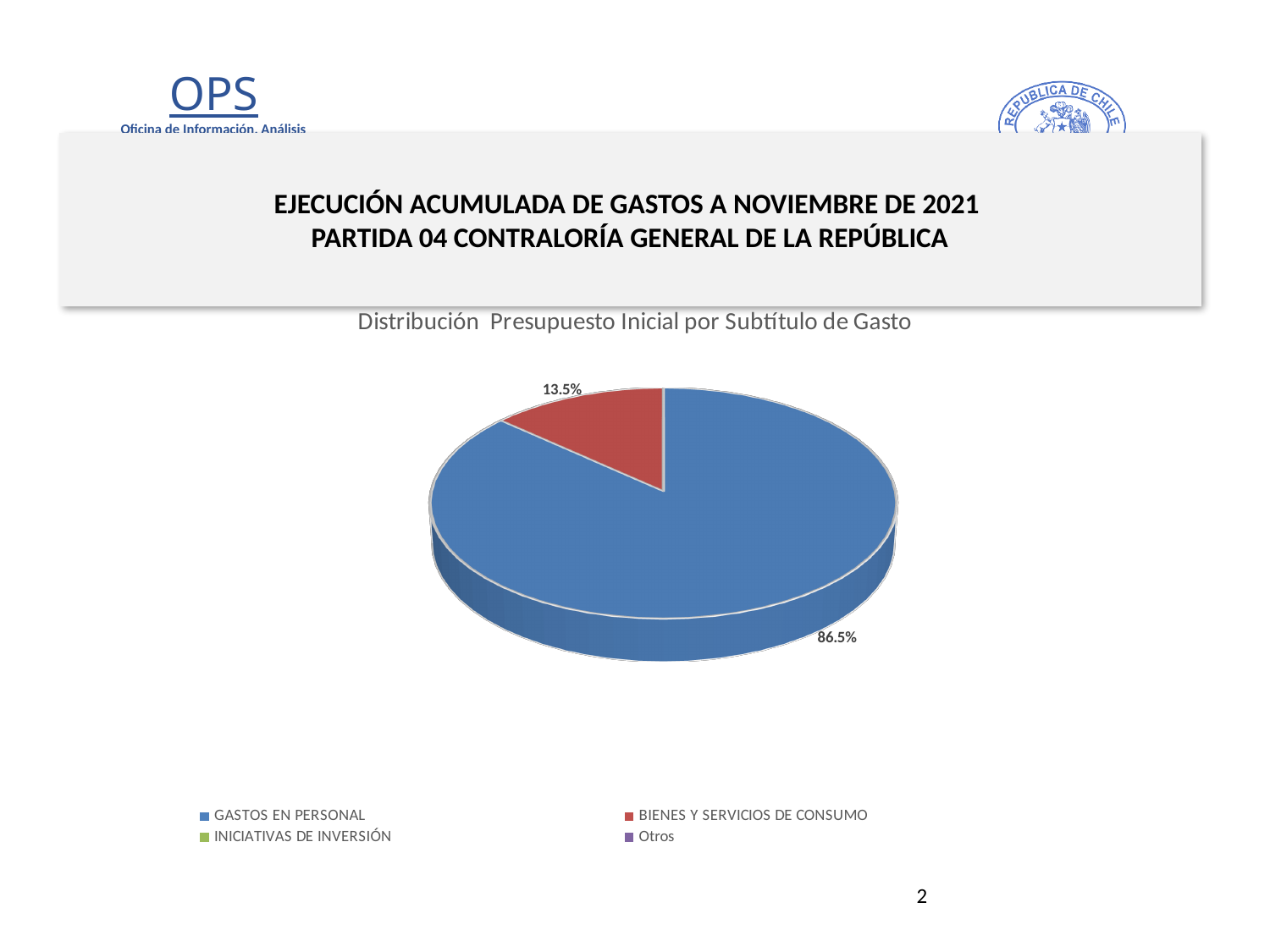
What is the title of the chart? Distribución Presupuesto Inicial por Subtítulo de Gasto What share of the pie does BIENES Y SERVICIOS DE CONSUMO represent? 13.5% What share of the pie does GASTOS EN PERSONAL represent? 86.5% What is the difference in percentage points between the GASTOS EN PERSONAL slice and the BIENES Y SERVICIOS DE CONSUMO slice? 73 percentage points Is the share for GASTOS EN PERSONAL greater or less than 50%? greater What kind of chart is shown on the slide? Pie chart Which of the two labelled slices is smaller, GASTOS EN PERSONAL or BIENES Y SERVICIOS DE CONSUMO? BIENES Y SERVICIOS DE CONSUMO Which category has the largest slice of the pie? GASTOS EN PERSONAL How many entries does the chart legend list? 4 How many slices with data labels are visible in the pie? 2 What colour is the slice for BIENES Y SERVICIOS DE CONSUMO? Red